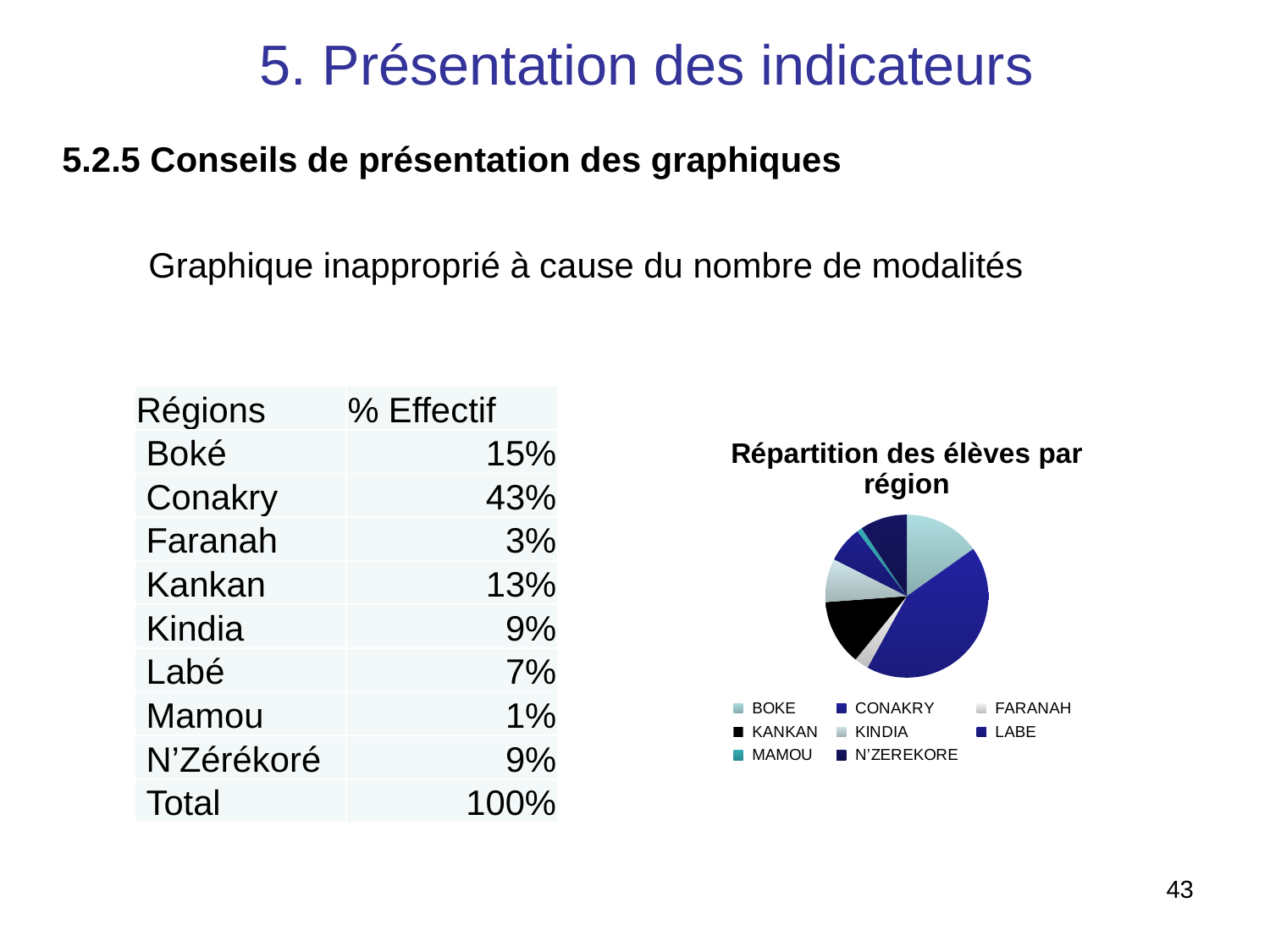
What is the % Effectif value for Kankan? 13% What kind of chart is shown on the slide? pie chart What is the total of all the region percentages shown? 100% What share of the pie does Conakry represent? 43% What is the difference in percentage points between Conakry and Boké? 28% How many entries does the pie chart's legend list? 8 What is the % Effectif value for Boké? 15% Which region has the largest slice of the pie chart? Conakry Which slice is larger, Kankan or Kindia? Kankan How many regions (slices) does the pie chart show? 8 What is the title of the pie chart? Répartition des élèves par région Which region has the smallest slice of the pie chart? Mamou